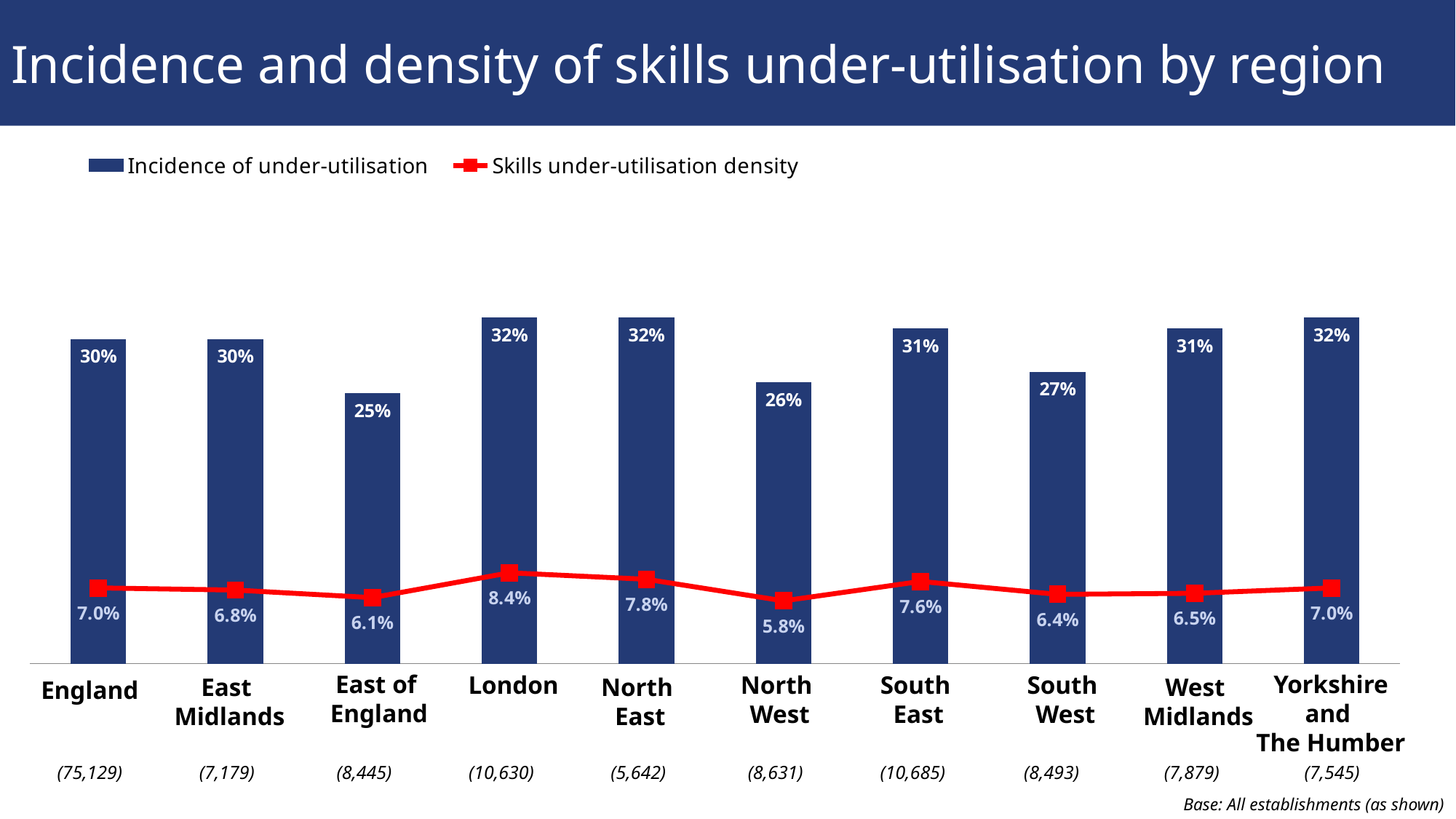
Which region has the lowest incidence of under-utilisation? East of England How many series does the legend list? 2 What is the skills under-utilisation density for the North West? 5.8% What is the incidence of under-utilisation for London? 32% Which region has the lowest skills under-utilisation density? North West What is the difference in skills under-utilisation density between London and the East Midlands? 1.6 percentage points What is the difference in incidence of under-utilisation between London and the South West? 5 percentage points What is the incidence of under-utilisation for the East of England? 25% What is the base number of establishments shown for the South East? 10,685 Which has a higher incidence of under-utilisation, the North West or the South East? South East Which region has the highest skills under-utilisation density? London How many regions are shown on the x axis? 10